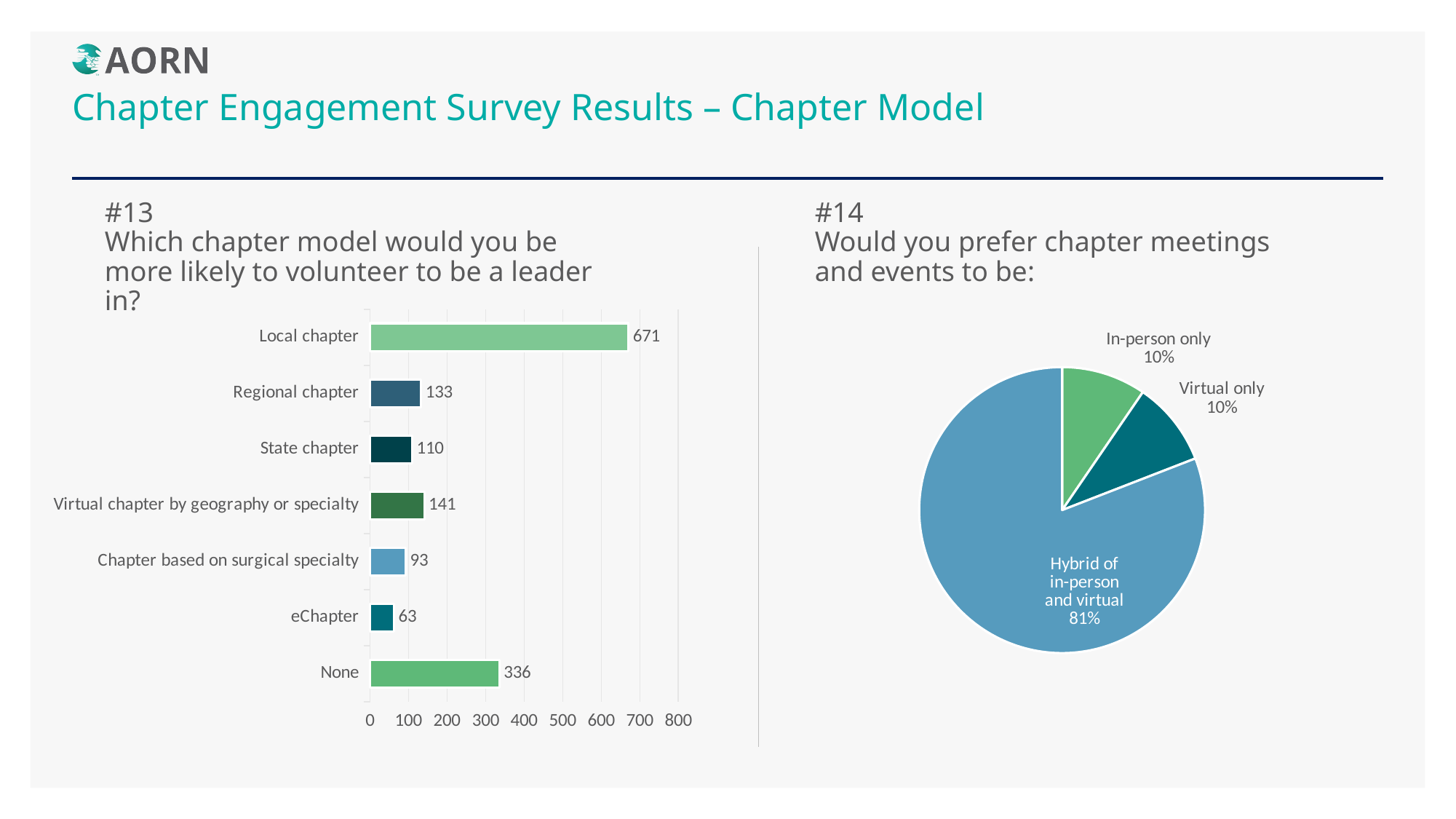
In the #14 pie chart (Would you prefer chapter meetings and events to be:), what share is Hybrid of in-person and virtual? 81% In the #13 chart, which category has the highest value? Local chapter What kind of chart is used for question #13? Bar chart In the #14 pie chart, what share is Virtual only? 10% In the #13 chart, what is the difference between Regional chapter and State chapter? 23 How many slices does the #14 pie chart have? 3 In the #13 chart, what is the value for None? 336 In the #13 chart (Which chapter model would you be more likely to volunteer to be a leader in?), what is the value for Local chapter? 671 In the #13 chart, which category has the lowest value? eChapter How many categories does the #13 bar chart show? 7 In the #13 chart, what is the value for Virtual chapter by geography or specialty? 141 In the #13 chart, which is larger, Chapter based on surgical specialty or eChapter? Chapter based on surgical specialty